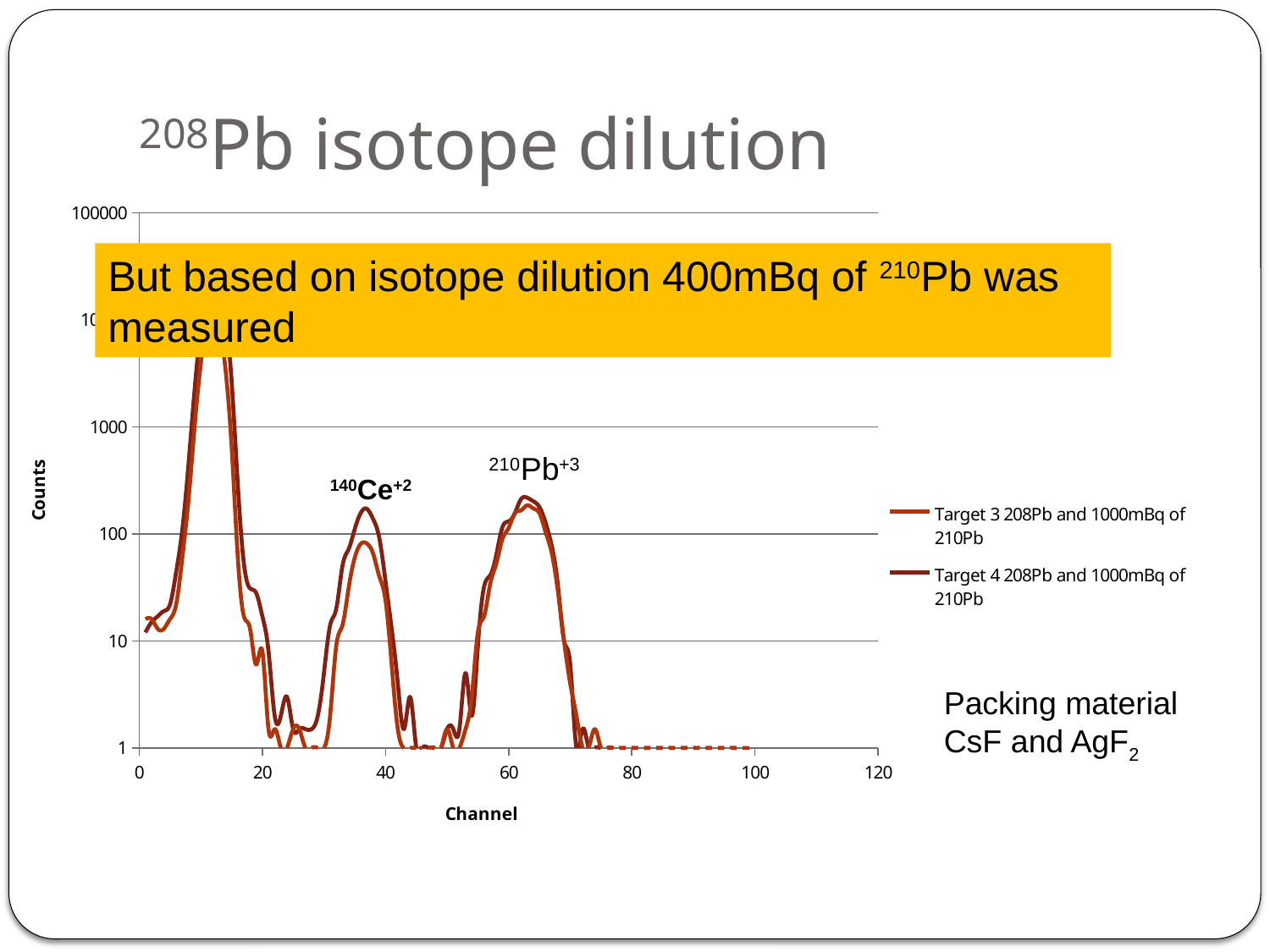
What kind of chart is shown on the slide? line chart How many series does the legend list? 2 Which series reaches a higher peak at the 140Ce+2 peak, Target 3 or Target 4? Target 4 Is the peak value of the 210Pb+3 peak greater or less than 1000? less Is the value of the counts at channel 90 greater or less than 10? less Which of the labelled peaks, 140Ce+2 or 210Pb+3, reaches higher counts? 210Pb+3 What is the label of the y axis? Counts Is the peak value of the 140Ce+2 peak for Target 3 208Pb and 1000mBq of 210Pb greater or less than 100? less What is the label of the x axis? Channel Do the counts rise or fall between channel 65 and channel 75? fall